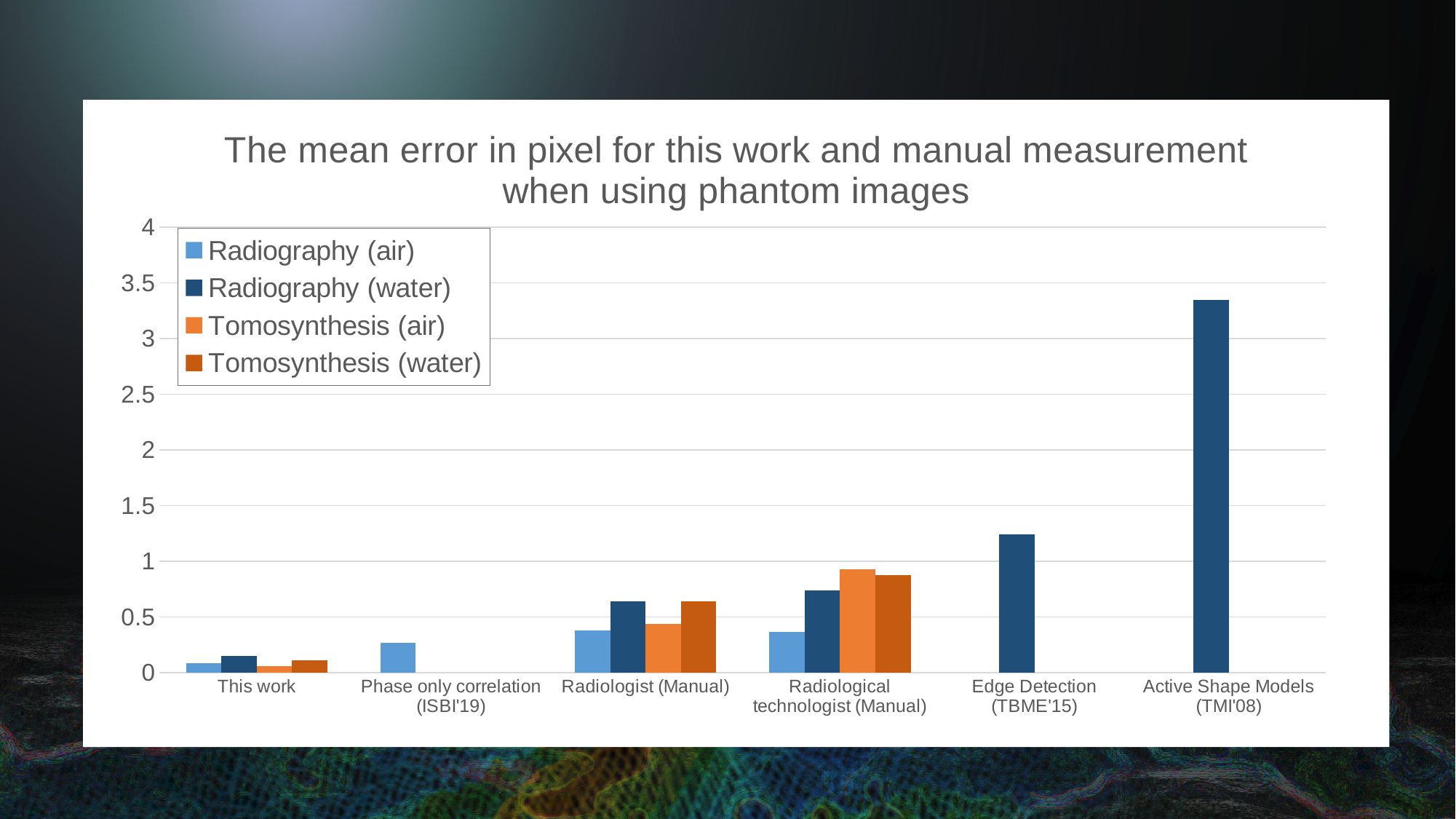
Which is larger, the Tomosynthesis (air) value for Radiologist (Manual) or for Radiological technologist (Manual)? Radiological technologist (Manual) Which category has the highest Radiography (water) value? Active Shape Models (TMI'08) Is the Radiography (air) value for Phase only correlation (ISBI'19) greater or less than 0.5? less Which series has the lowest value for This work? Tomosynthesis (air) What kind of chart is shown on the slide? bar chart How many series does the legend list? 4 Is the Radiography (water) value for Active Shape Models (TMI'08) greater or less than 3? greater What is the title of the chart? The mean error in pixel for this work and manual measurement when using phantom images How many categories are shown along the x axis? 6 Which category has the tallest bar overall in the chart? Active Shape Models (TMI'08) Is the Tomosynthesis (air) value for Radiological technologist (Manual) greater or less than 1? less